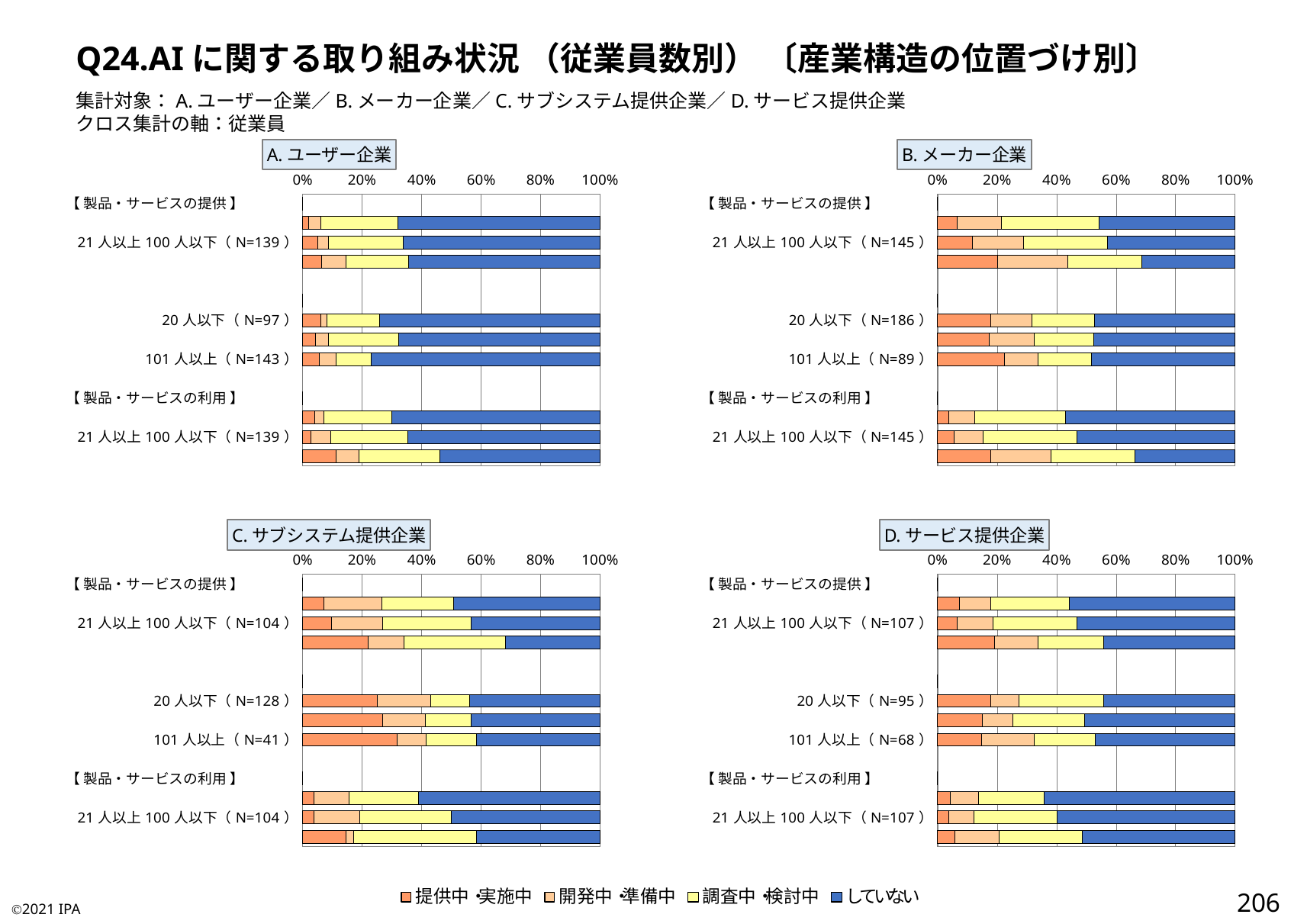
In the chart C. サブシステム提供企業, for 20人以下 (N=128) under 製品・サービスの提供, is the share of していない greater or less than 60%? less How many charts are shown on the slide? 4 In the chart A. ユーザー企業, for 20人以下 (N=97) under 製品・サービスの提供, is the share of していない greater or less than 60%? greater In the chart D. サービス提供企業, for 21人以上100人以下 (N=107) under 製品・サービスの利用, is the share of していない greater or less than 40%? greater What kind of chart is used for A. ユーザー企業? stacked bar chart For 20人以下 under 製品・サービスの提供, which chart shows a larger share of 提供中・実施中: A. ユーザー企業 or C. サブシステム提供企業? C. サブシステム提供企業 How many series does the legend at the bottom of the slide list? 4 In the chart B. メーカー企業, what is the N value shown for 20人以下? N=186 What is the last entry in the legend at the bottom of the slide? していない